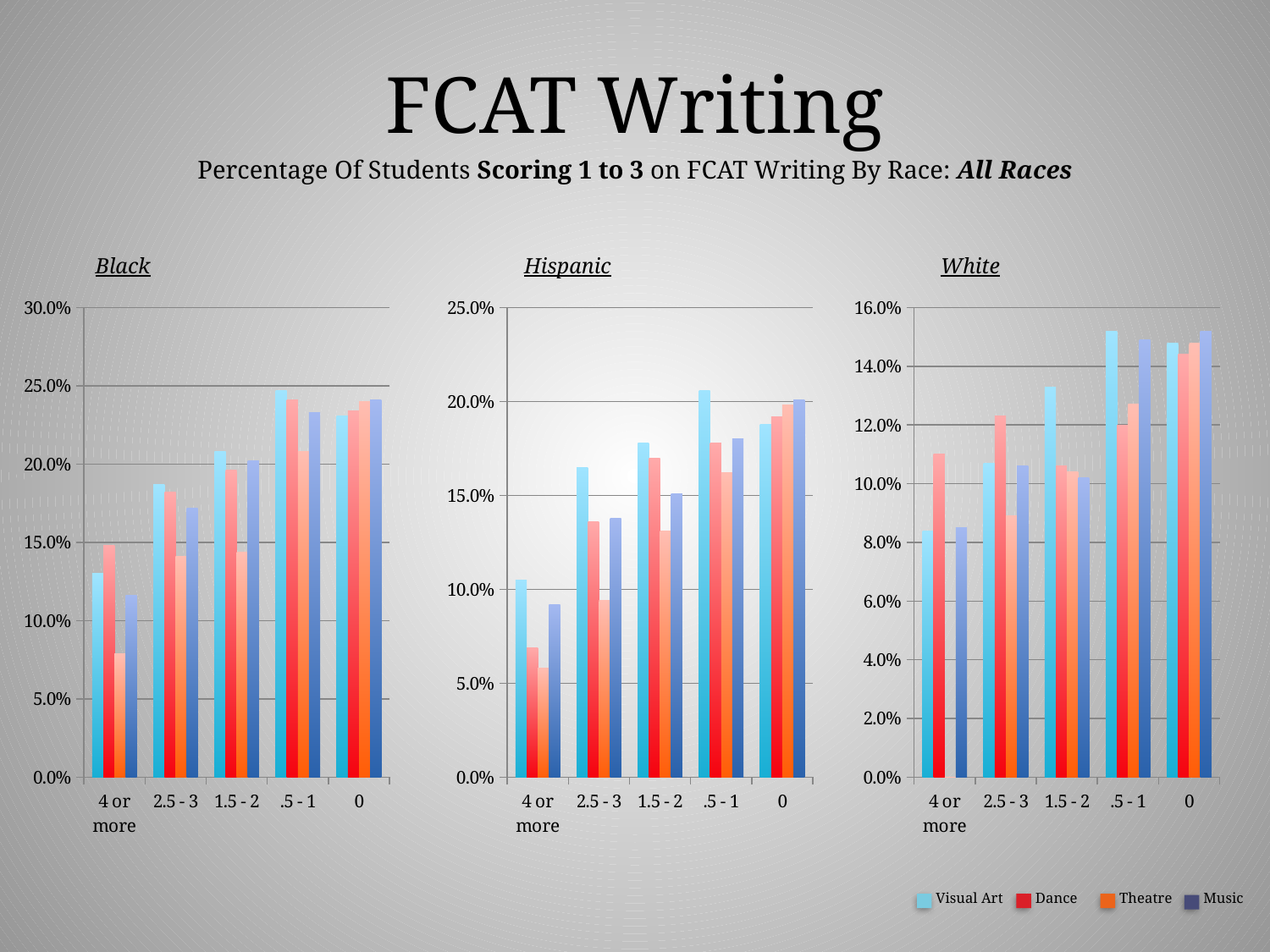
In the Black chart, which category has the lowest Dance value? 4 or more In the White chart, which is larger for '4 or more': Dance or Visual Art? Dance In the Black chart, is the Visual Art value for '4 or more' greater or less than 15.0%? less In the White chart, is the Dance value for '4 or more' greater or less than 10.0%? greater How many categories are shown on the x axis of the Hispanic chart? 5 In the Hispanic chart, is the Visual Art value for '.5 - 1' greater or less than 20.0%? greater In the Hispanic chart, do the Music values rise or fall from '4 or more' to '0'? rise In the Black chart, which is larger for '4 or more': Visual Art or Dance? Dance How many series does the legend list? 4 What kind of chart is the Black chart? bar chart What are the titles of the three charts on the slide? Black, Hispanic, White